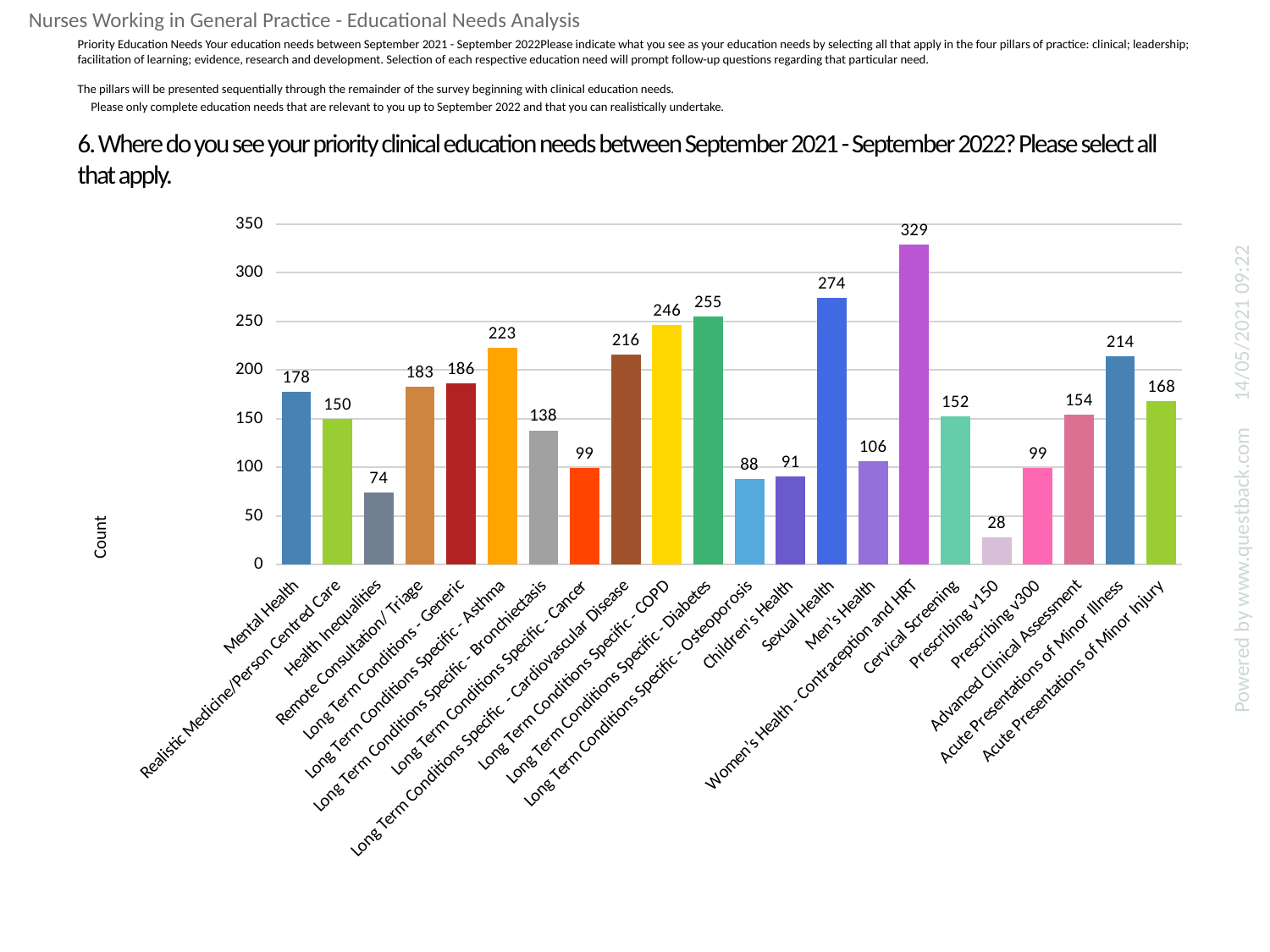
What is the count for Sexual Health? 274 What kind of chart is shown on the slide? Bar chart What is the count for Acute Presentations of Minor Injury? 168 What is the label on the vertical axis of the chart? Count What is the count for Long Term Conditions Specific - Asthma? 223 Which category has the highest count? Women's Health - Contraception and HRT Which category has the lowest count? Prescribing v150 What is the difference between the counts for Long Term Conditions Specific - Diabetes and Long Term Conditions Specific - COPD? 9 How many categories are shown on the chart? 22 Which has a higher count, Mental Health or Remote Consultation/Triage? Remote Consultation/Triage What is the count for Health Inequalities? 74 What is the difference between the counts for Women's Health - Contraception and HRT and Sexual Health? 55